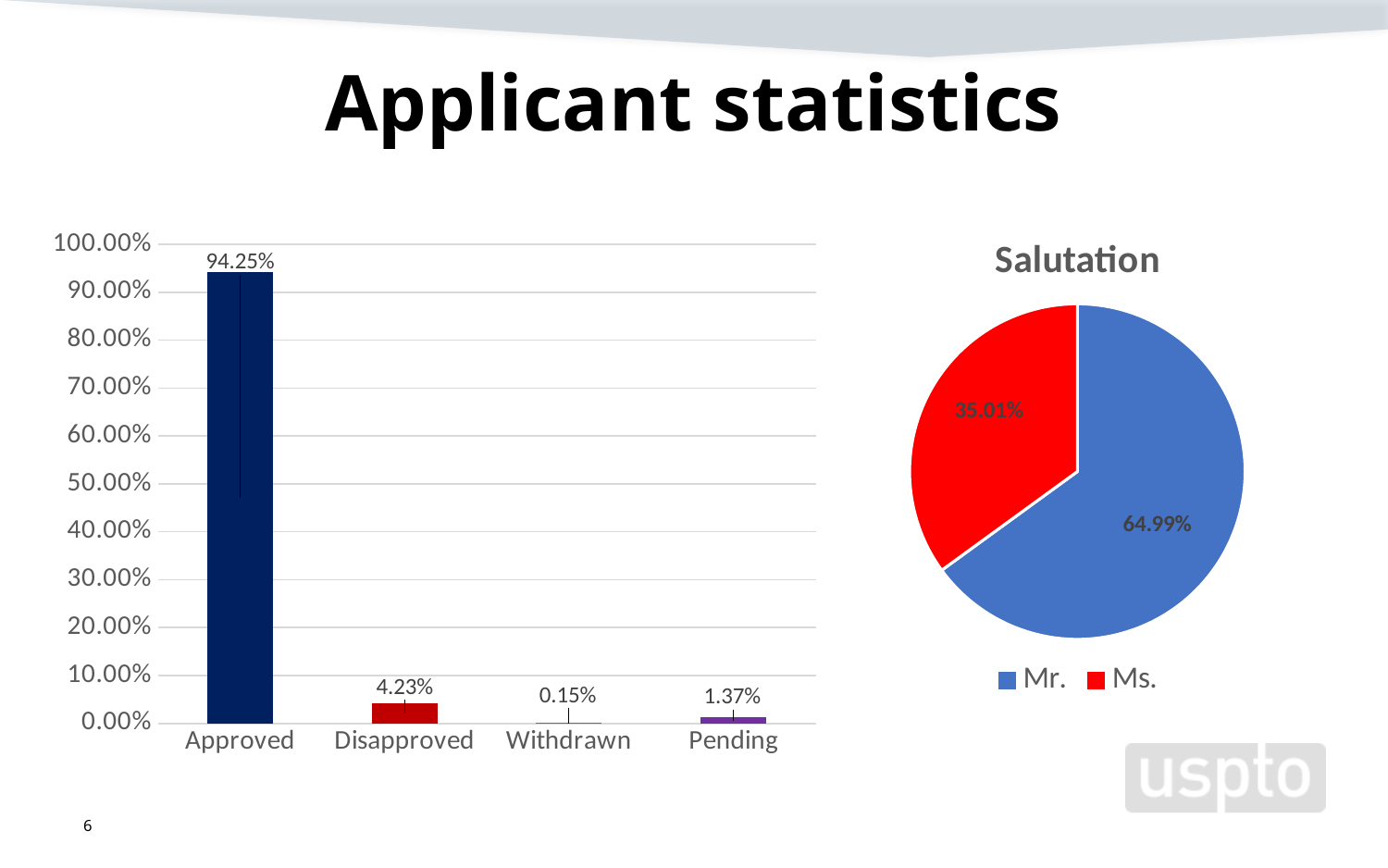
What kind of chart is the Salutation chart on the right? Pie chart In the bar chart on the left, which category has the highest value? Approved How many categories does the bar chart on the left show? 4 In the bar chart on the left, which is larger, Disapproved or Pending? Disapproved In the bar chart on the left, what is the value for Pending? 1.37% In the bar chart on the left, what is the value for Withdrawn? 0.15% In the bar chart on the left, what is the value for Approved? 94.25% In the Salutation pie chart, what share does Ms. have? 35.01% In the bar chart on the left, which category has the lowest value? Withdrawn In the Salutation pie chart, what share does Mr. have? 64.99% In the bar chart on the left, what is the value for Disapproved? 4.23% In the bar chart on the left, what is the difference between the Approved and Disapproved values? 90.02%